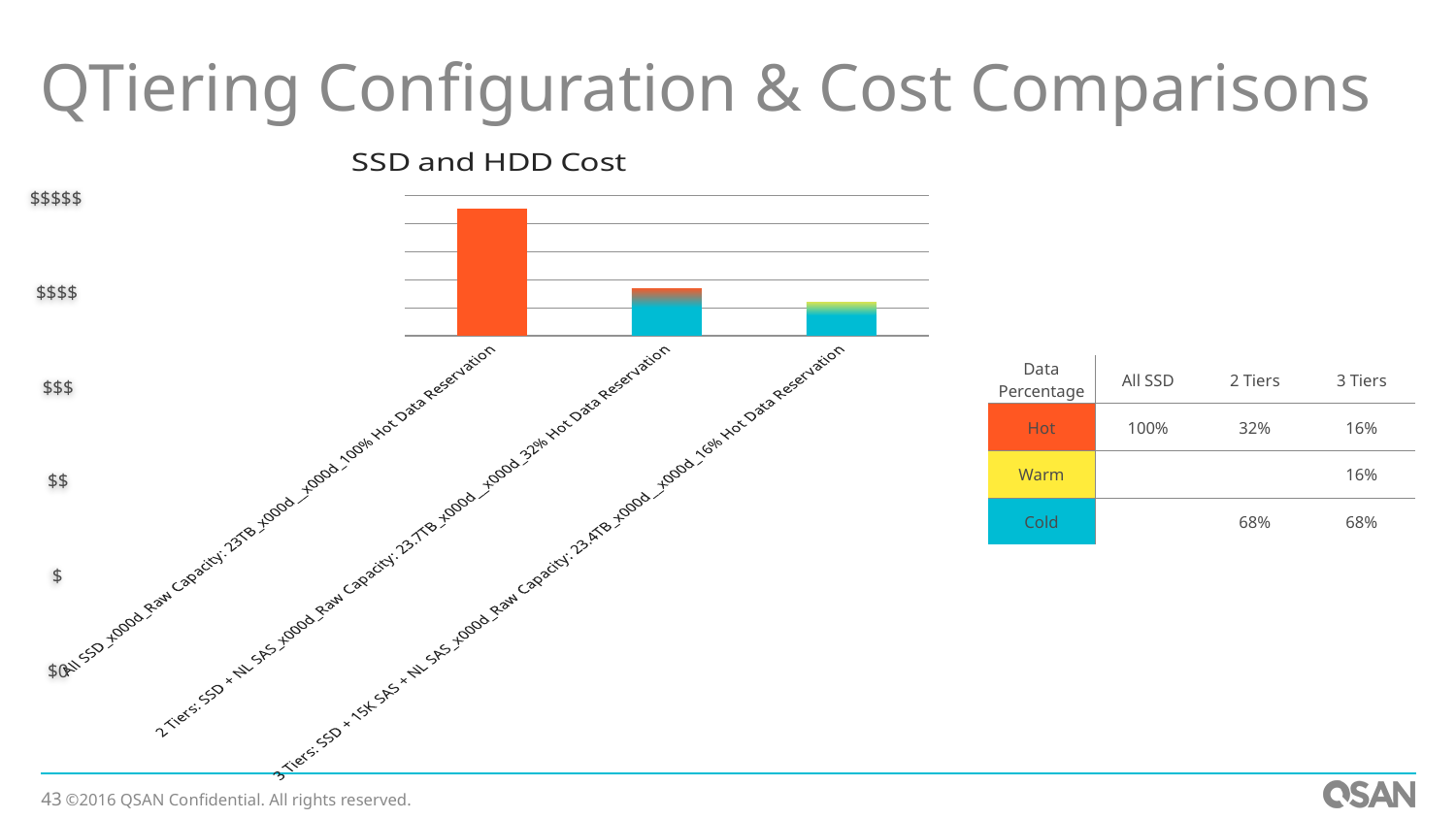
Which configuration has the lowest cost bar in the chart? 3 Tiers: SSD + 15K SAS + NL SAS Which bar is taller: 2 Tiers: SSD + NL SAS or 3 Tiers: SSD + 15K SAS + NL SAS? 2 Tiers: SSD + NL SAS Which configuration has the highest cost bar in the chart? All SSD Do the bar heights rise or fall from left to right across the chart? fall What kind of chart is shown on the slide? bar chart What is the title of the chart? SSD and HDD Cost How many bars (configurations) are plotted in the chart? 3 Which bar is taller: All SSD or 2 Tiers: SSD + NL SAS? All SSD What hot data reservation percentage is stated in the category label for the 3 Tiers configuration? 16% What colour is the All SSD bar in the chart? orange What is the raw capacity stated in the category label for the 2 Tiers configuration? 23.7TB